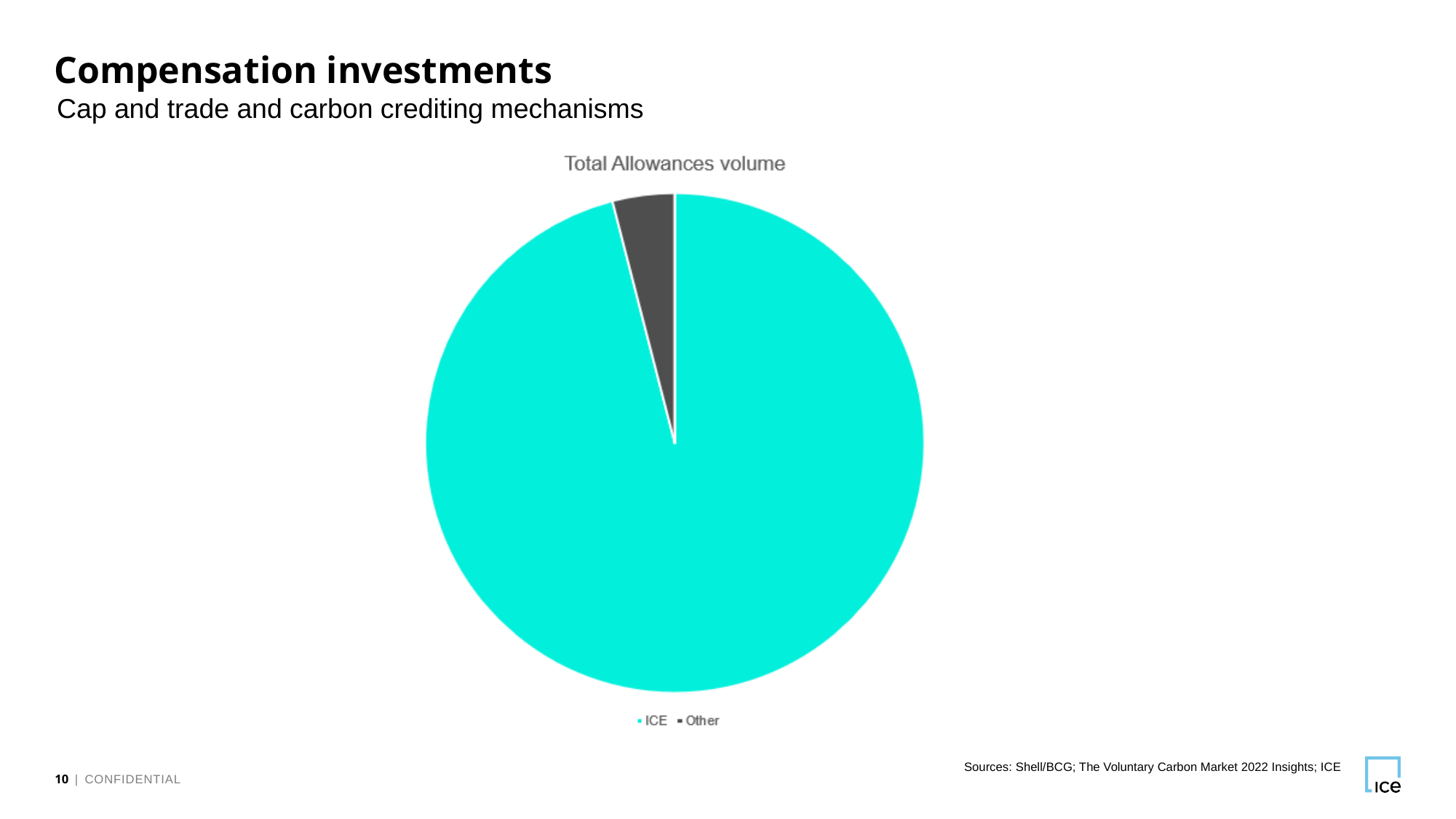
Which slice is the smallest in the pie chart? Other What colour is the ICE slice in the pie chart? cyan Is the share of the Other slice greater or less than 50%? less What kind of chart is shown on the slide? pie chart Which is larger, the ICE slice or the Other slice? ICE How many slices does the pie chart have? 2 Is the share of the ICE slice greater or less than 50%? greater Which slice is the largest in the pie chart? ICE How many entries does the legend list? 2 What is the title of the chart? Total Allowances volume